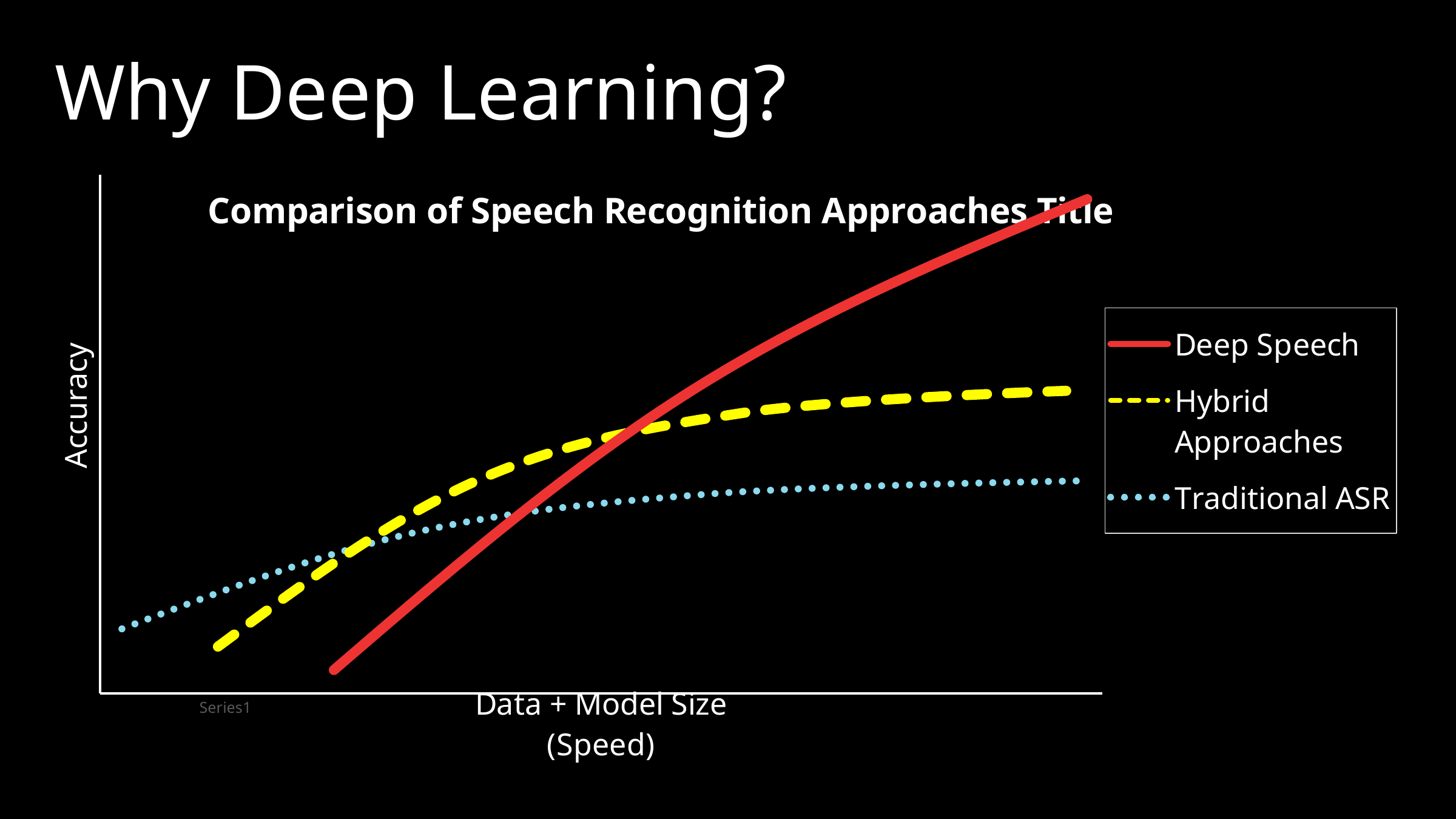
Which series has the lowest accuracy at the right end of the chart? Traditional ASR Does the Deep Speech line rise or fall as Data + Model Size increases? Rises What kind of chart is shown on the slide? Line chart Which series reaches the highest accuracy at the right end of the chart? Deep Speech What is the title of the chart? Comparison of Speech Recognition Approaches Title Does the Traditional ASR line rise or fall along the x axis? Rises At the right end of the chart, which is higher: Deep Speech or Hybrid Approaches? Deep Speech At the left end of the chart, which series has the highest accuracy? Traditional ASR What is the label of the vertical axis? Accuracy How many series does the legend list? 3 At the right end of the chart, which is higher: Hybrid Approaches or Traditional ASR? Hybrid Approaches